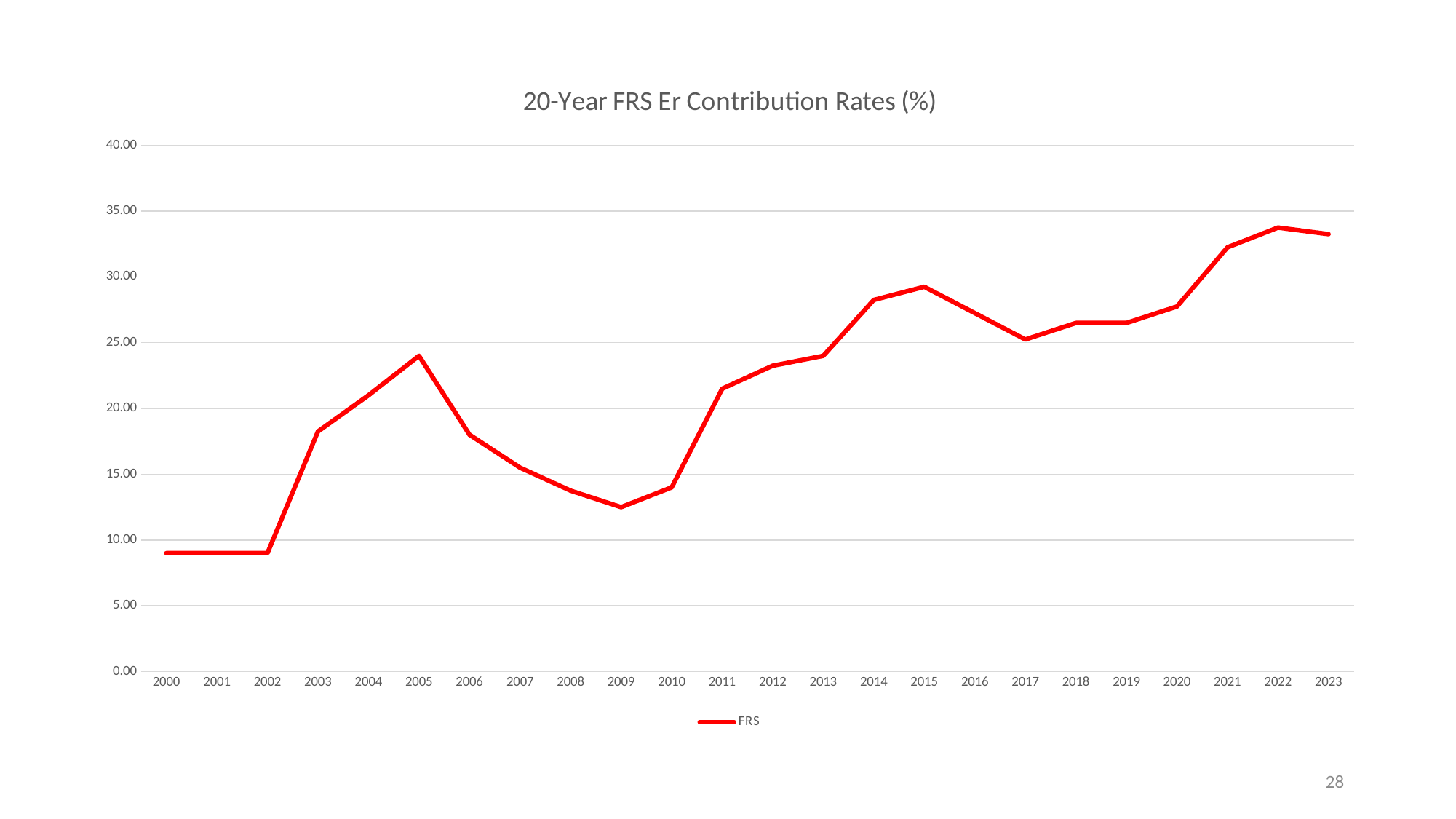
Which year has the larger value, 2015 or 2017? 2015 Is the value for 2005 greater or less than 20.00? greater Which year has the larger value, 2005 or 2009? 2005 How many years are plotted along the x axis? 24 Overall, do the FRS contribution rates rise or fall from 2000 to 2023? rise What kind of chart is shown on the slide? line chart How many series does the legend list? 1 Is the value for 2000 greater or less than 10.00? less Is the value for 2014 greater or less than 25.00? greater What is the title of the chart? 20-Year FRS Er Contribution Rates (%)